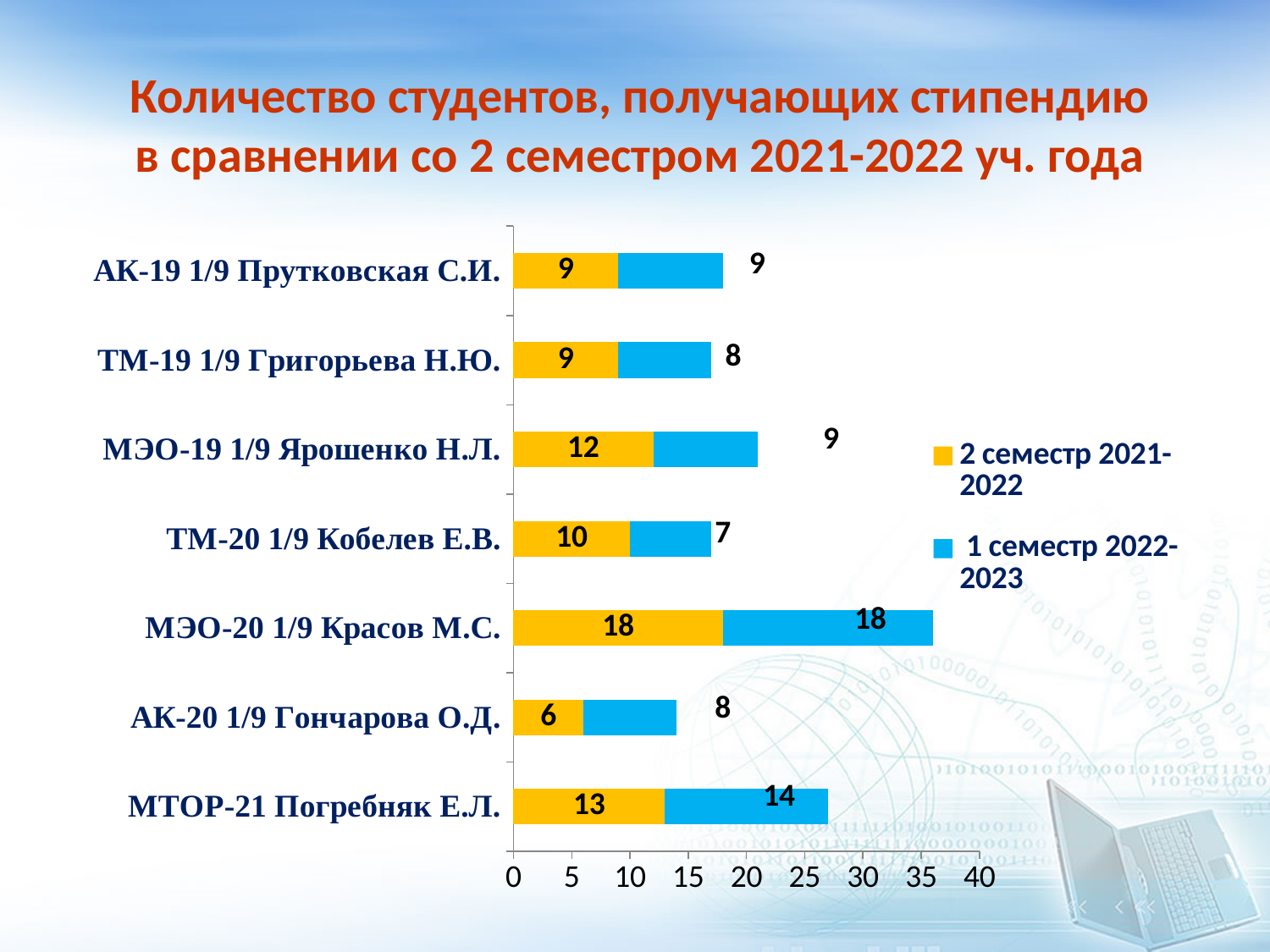
What is the difference between the 2 семестр 2021-2022 value and the 1 семестр 2022-2023 value for АК-20 1/9 Гончарова О.Д.? 2 What is the value for ТМ-20 1/9 Кобелев Е.В. in the 1 семестр 2022-2023 series? 7 Which colour represents the 1 семестр 2022-2023 series? Blue What is the value for МЭО-19 1/9 Ярошенко Н.Л. in the 2 семестр 2021-2022 series? 12 What type of chart is shown on the slide? Stacked bar chart Which is larger for ТМ-19 1/9 Григорьева Н.Ю.: the 2 семестр 2021-2022 value or the 1 семестр 2022-2023 value? 2 семестр 2021-2022 What is the value for МТОР-21 Погребняк Е.Л. in the 1 семестр 2022-2023 series? 14 What is the total of the stacked bar for МЭО-20 1/9 Красов М.С.? 36 Which category has the lowest value in the 2 семестр 2021-2022 series? АК-20 1/9 Гончарова О.Д. How many categories (groups) are shown on the chart? 7 Which category has the highest value in the 2 семестр 2021-2022 series? МЭО-20 1/9 Красов М.С. How many series does the legend list? 2